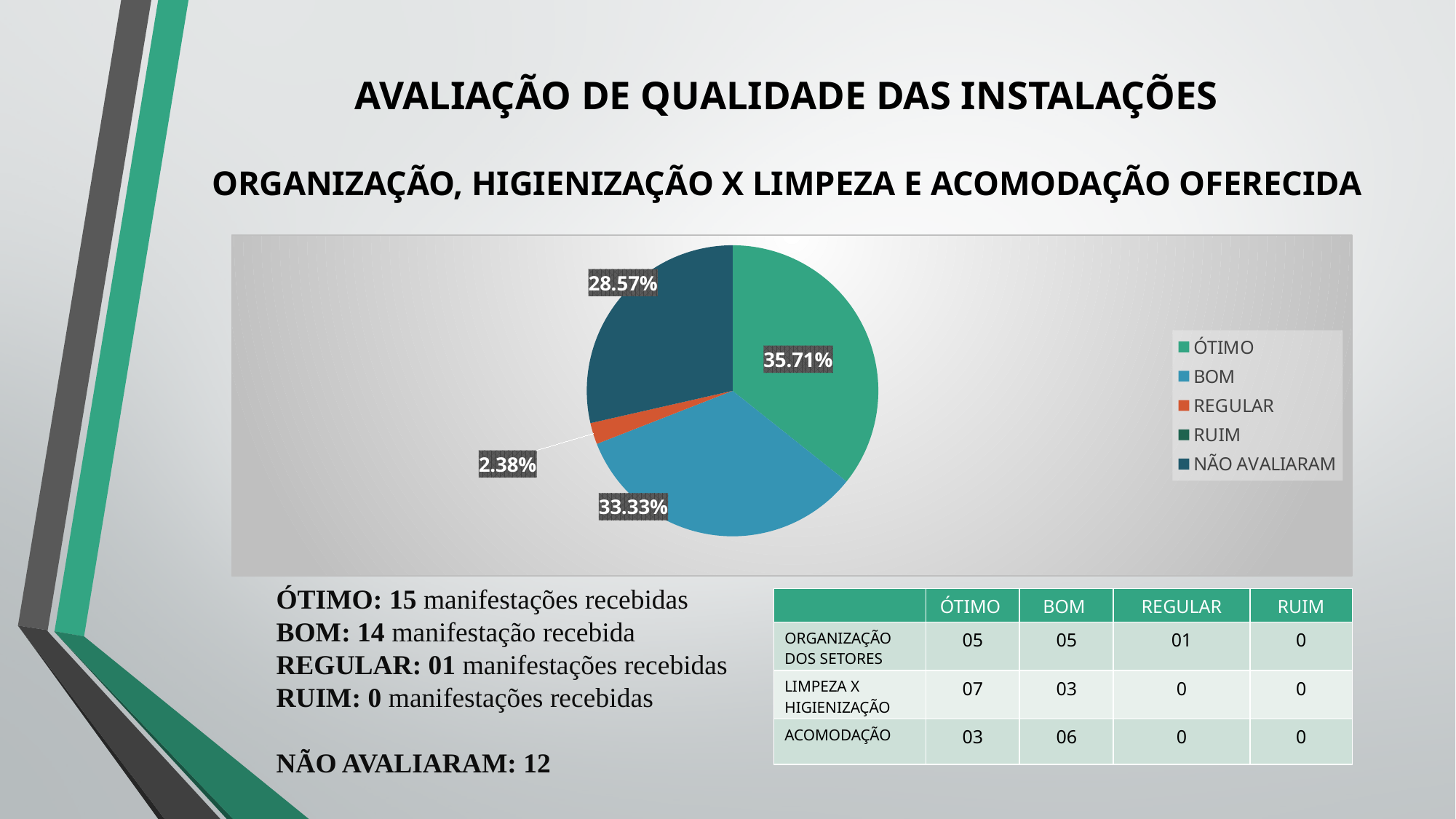
Which category has the largest slice of the pie? ÓTIMO Which labelled slice of the pie is the smallest? REGULAR How many entries does the legend of the pie chart list? 5 What share of the pie does ÓTIMO have? 35.71% Which legend entry is shown in orange? REGULAR What share of the pie does NÃO AVALIARAM have? 28.57% What share of the pie does BOM have? 33.33% Which slice is larger, BOM or NÃO AVALIARAM? BOM What is the difference between the ÓTIMO share and the BOM share? 2.38% What is the difference between the BOM share and the NÃO AVALIARAM share? 4.76% What kind of chart is shown on the slide? pie chart